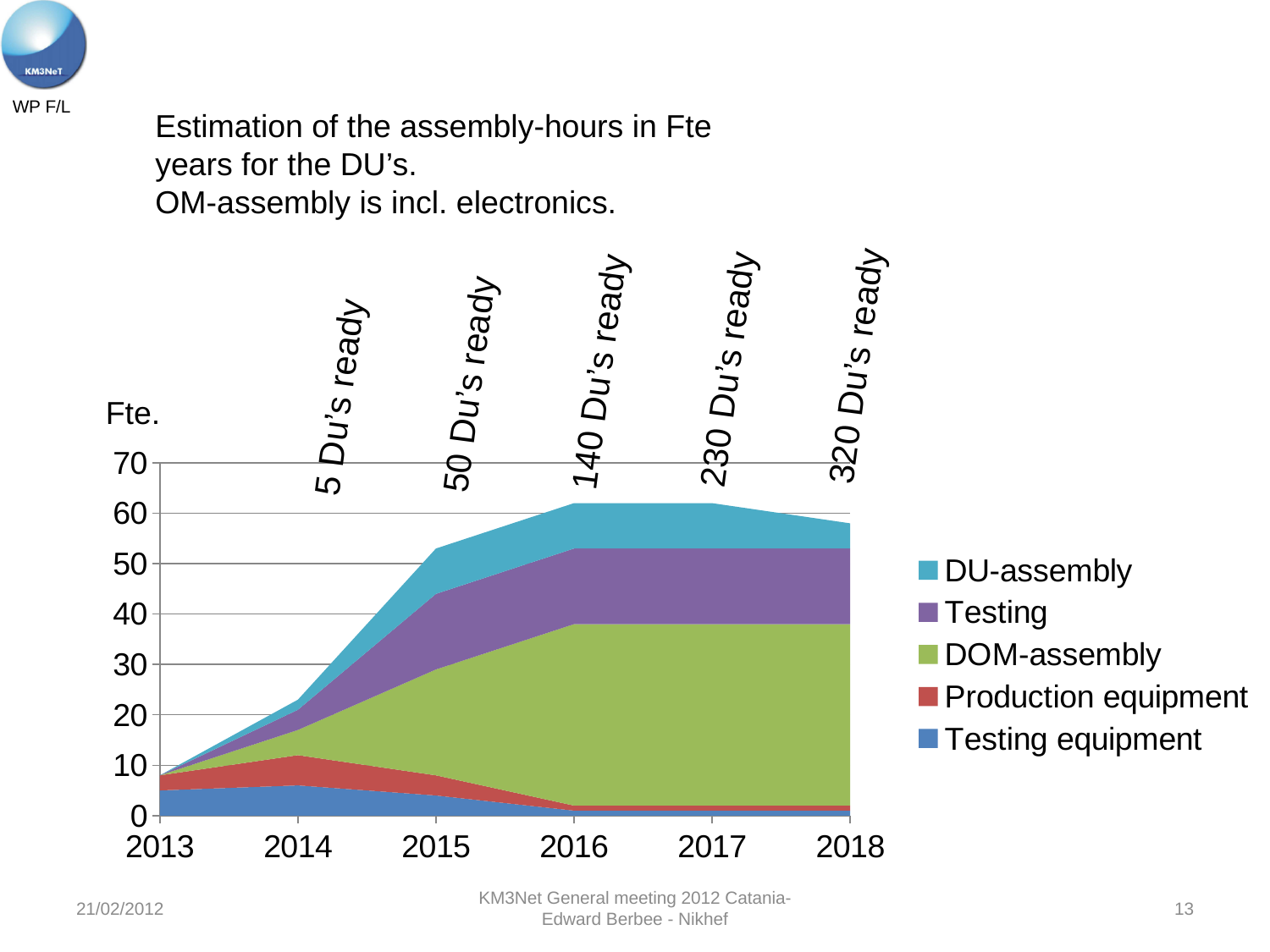
Is the total Fte in 2014 greater or less than 20? greater Is the total Fte in 2013 greater or less than 10? less Is the total Fte in 2015 greater or less than 50? greater Which year has the lowest total Fte? 2013 What annotation is written above the year 2016? 140 Du's ready What kind of chart is shown on the slide? stacked area chart Does the total Fte rise or fall from 2013 to 2016? rise Which series is plotted at the top of the stack? DU-assembly Which year has the larger total Fte, 2014 or 2015? 2015 How many years are shown along the x axis? 6 How many series does the legend list? 5